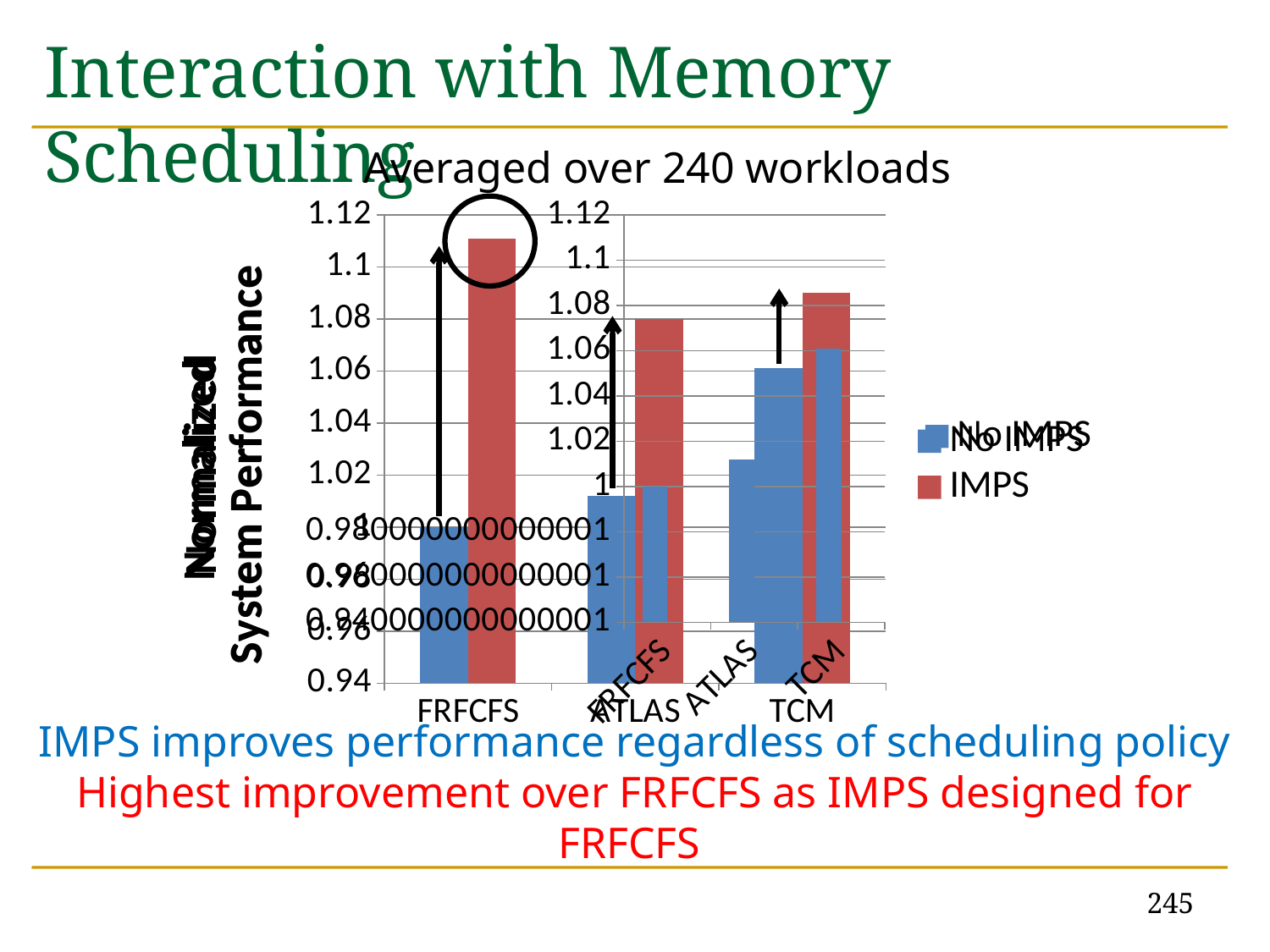
How many series does the chart's legend list? 2 In the front chart (y axis 0.94 to 1.12), which category has the lowest No IMPS bar? FRFCFS In the front chart (y axis 0.94 to 1.12), for FRFCFS, which is larger: the IMPS bar or the No IMPS bar? IMPS What kind of chart is shown on the slide? bar chart In the front chart (y axis 0.94 to 1.12), is the IMPS value for FRFCFS greater or less than 1.08? greater How many scheduling policy categories are shown on the x axis of the chart? 3 In the front chart (y axis 0.94 to 1.12), for TCM, which is larger: the IMPS bar or the No IMPS bar? IMPS In the front chart (y axis 0.94 to 1.12), which category has the highest IMPS bar? FRFCFS In the front chart (y axis 0.94 to 1.12), is the No IMPS value for TCM greater or less than 1.04? greater What are the two series named in the chart's legend? No IMPS and IMPS What is the subtitle printed above the chart? Averaged over 240 workloads